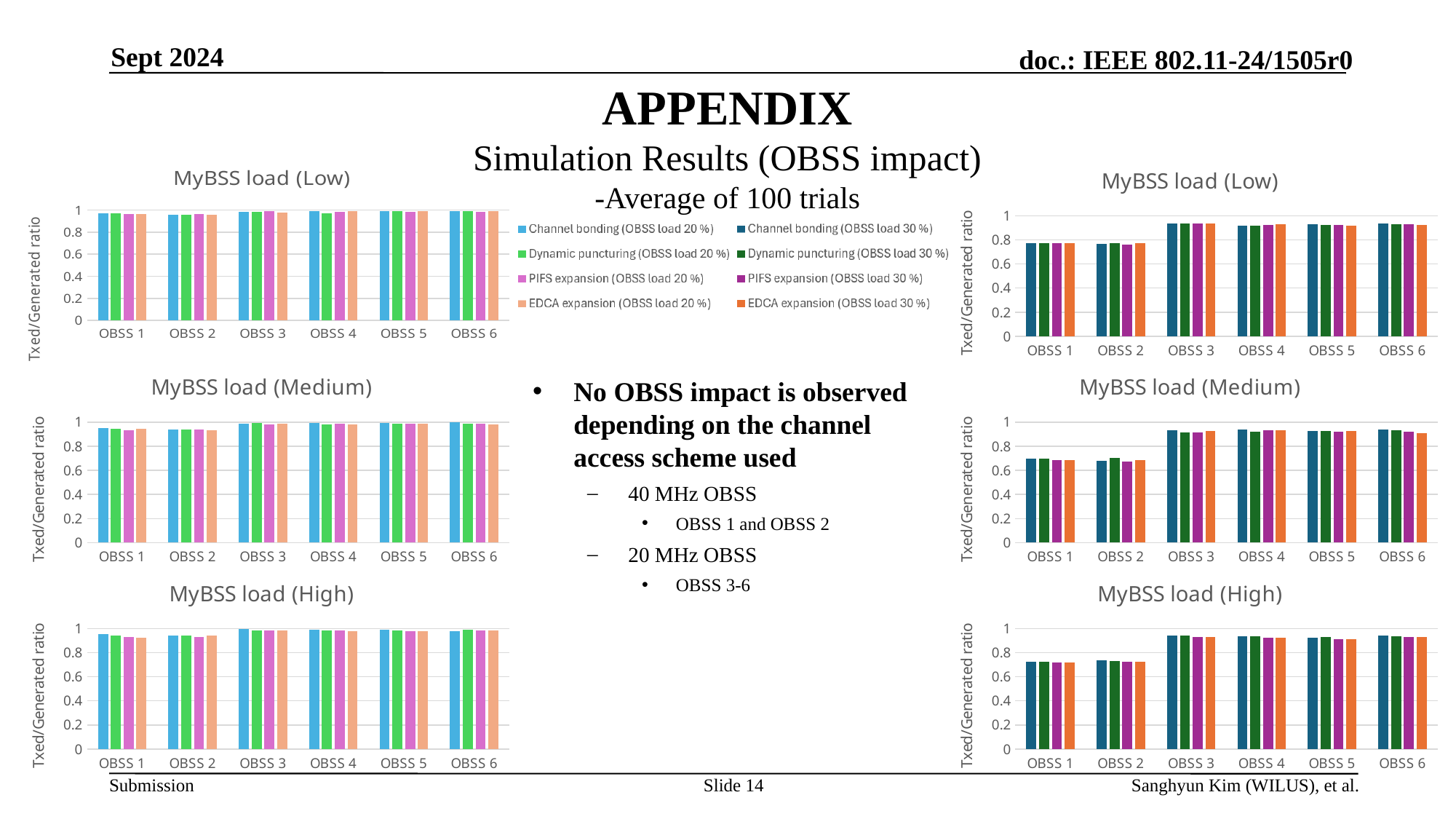
How many OBSS categories are shown on the x axis of the bottom-right 'MyBSS load (High)' chart? 6 In the middle-right 'MyBSS load (Medium)' chart, which has the larger Channel bonding (OBSS load 30 %) value, OBSS 1 or OBSS 3? OBSS 3 In the bottom-right 'MyBSS load (High)' chart, which has the larger PIFS expansion (OBSS load 30 %) value, OBSS 2 or OBSS 4? OBSS 4 What is the y-axis label of the bottom-left 'MyBSS load (High)' chart? Txed/Generated ratio How many bars are plotted for each OBSS category in the middle-left 'MyBSS load (Medium)' chart? 4 How many series does the legend on the slide list in total? 8 In the middle-right 'MyBSS load (Medium)' chart, is the Channel bonding (OBSS load 30 %) value for OBSS 1 greater or less than 0.8? less In the top-right 'MyBSS load (Low)' chart, is the Dynamic puncturing (OBSS load 30 %) value for OBSS 3 greater or less than 0.8? greater What is the title of the middle-left chart? MyBSS load (Medium) In the bottom-right 'MyBSS load (High)' chart, is the EDCA expansion (OBSS load 30 %) value for OBSS 2 greater or less than 0.8? less What kind of chart is the top-left chart titled 'MyBSS load (Low)'? bar chart